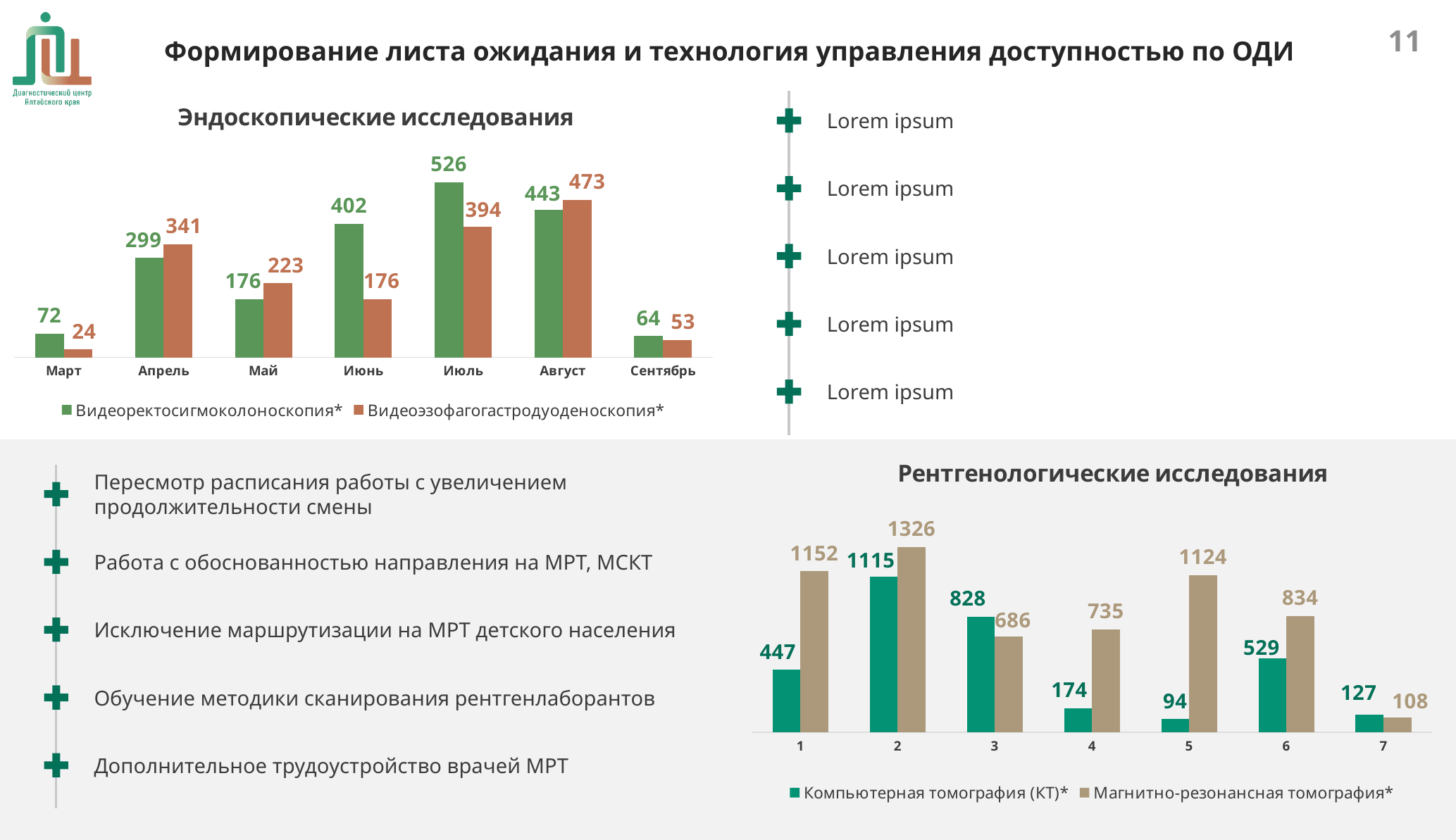
In the "Рентгенологические исследования" chart, what is the difference between Магнитно-резонансная томография* and Компьютерная томография (КТ)* at category 1? 705 What type of chart is the "Рентгенологические исследования" chart? Bar chart In the "Эндоскопические исследования" chart, which series is larger in Июнь? Видеоректосигмоколоноскопия* In the "Эндоскопические исследования" chart, how many months are shown on the x axis? 7 In the "Эндоскопические исследования" chart, what is the value for Видеоректосигмоколоноскопия* in Июль? 526 In the "Рентгенологические исследования" chart, which category has the highest value for Магнитно-резонансная томография*? 2 In the "Рентгенологические исследования" chart, how many series does the legend list? 2 In the "Эндоскопические исследования" chart, what is the difference between the two series in Август? 30 In the "Рентгенологические исследования" chart, which category has the lowest value for Компьютерная томография (КТ)*? 5 In the "Эндоскопические исследования" chart, what is the value for Видеоэзофагогастродуоденоскопия* in Апрель? 341 In the "Рентгенологические исследования" chart, what is the value for Компьютерная томография (КТ)* at category 3? 828 In the "Эндоскопические исследования" chart, which month has the lowest value for Видеоэзофагогастродуоденоскопия*? Март